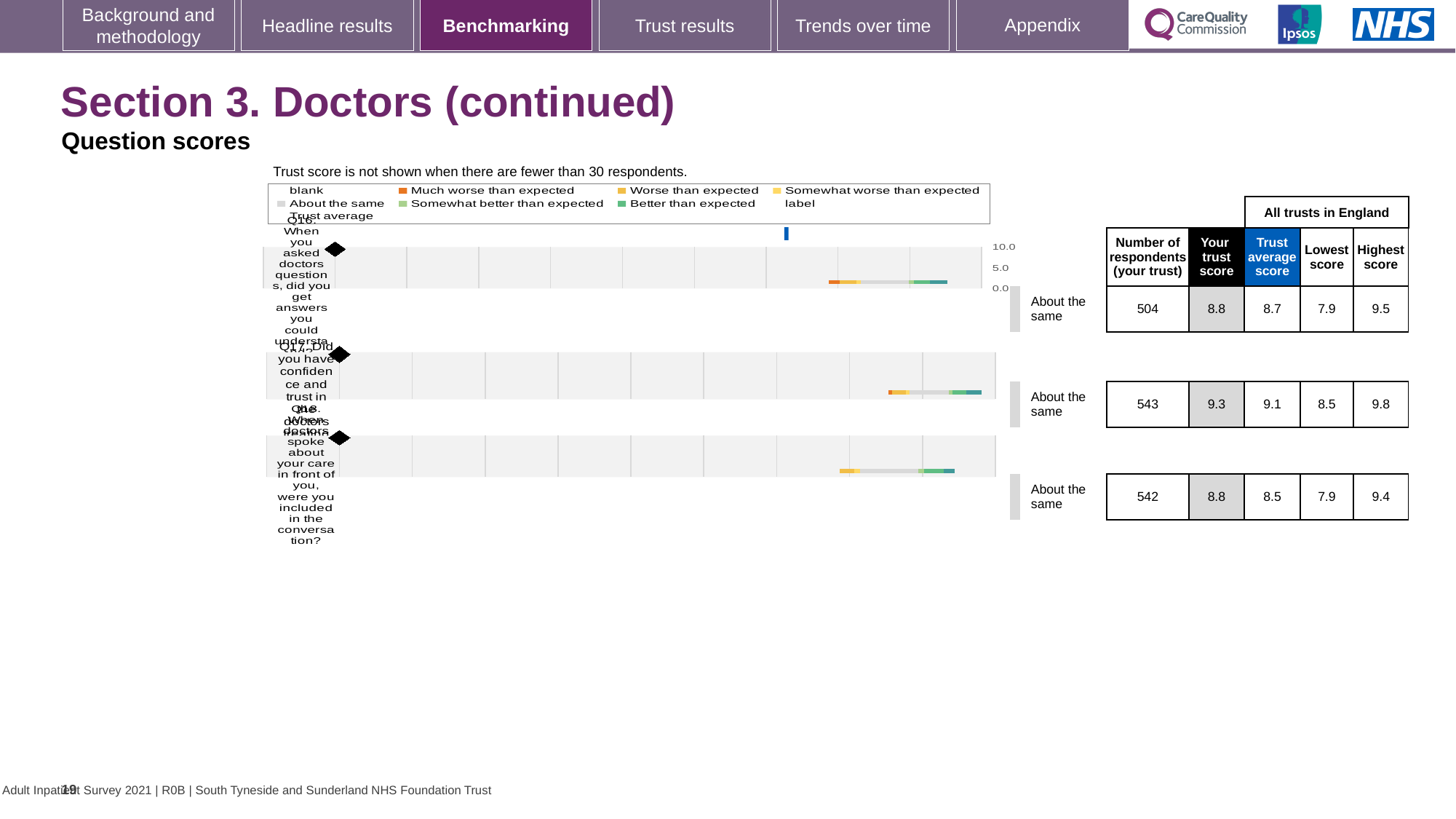
What benchmark category is shown for Q17? About the same What is the number of respondents (your trust) for Q16? 504 Which question has the highest 'Your trust score'? Q17 What is your trust score for Q17? 9.3 What colour does the legend use for 'Much worse than expected'? Orange What is the highest score across all trusts in England for Q17? 9.8 How many questions are plotted in the question scores chart? 3 For Q16, which is larger: your trust score or the trust average score? Your trust score What kind of chart is used to show the question scores on this slide? bar chart What is the lowest score across all trusts in England for Q18? 7.9 What is the difference between the highest score and the lowest score for Q16? 1.6 What is the trust average score for Q18? 8.5